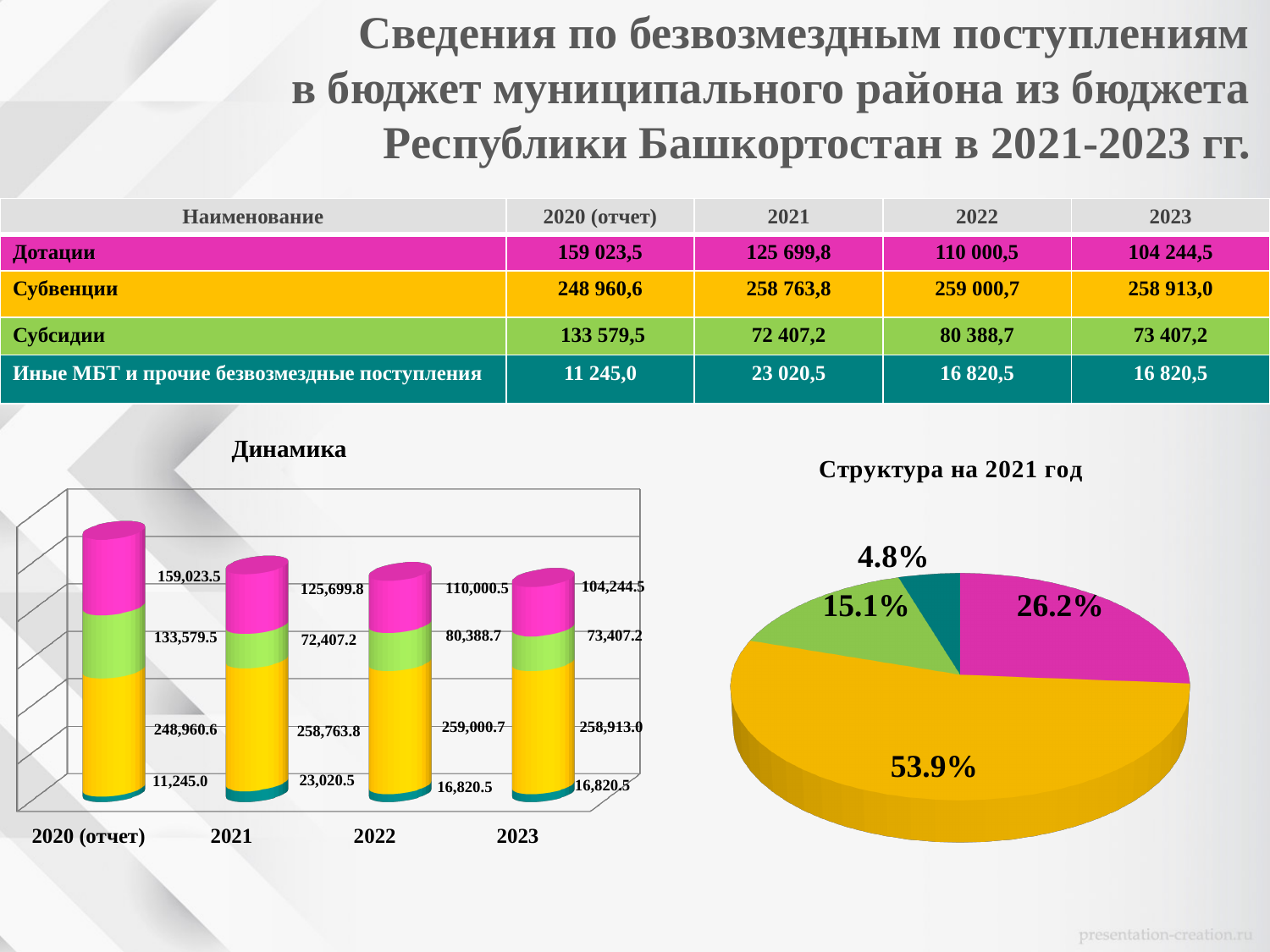
In the "Динамика" chart, does the pink segment value rise or fall from 2020 (отчет) to 2023? fall In the "Динамика" chart, what is the difference between the pink segment values for 2020 (отчет) and 2023? 54,779.0 In the "Динамика" chart, what is the value of the yellow segment for 2022? 259,000.7 In the "Структура на 2021 год" chart, what is the share of the smallest slice? 4.8% How many year categories are shown on the x axis of the "Динамика" chart? 4 What kind of chart is the "Динамика" chart? bar chart In the "Структура на 2021 год" chart, how many slices does the pie have? 4 In the "Динамика" chart, what is the value of the top pink segment for 2021? 125,699.8 In the "Динамика" chart, what is the value of the bottom teal segment for 2020 (отчет)? 11,245.0 In the "Структура на 2021 год" chart, which slice has the largest share? 53.9% What kind of chart is the "Структура на 2021 год" chart? pie chart In the "Динамика" chart, what is the total of the stacked bar for 2021? 479,891.3